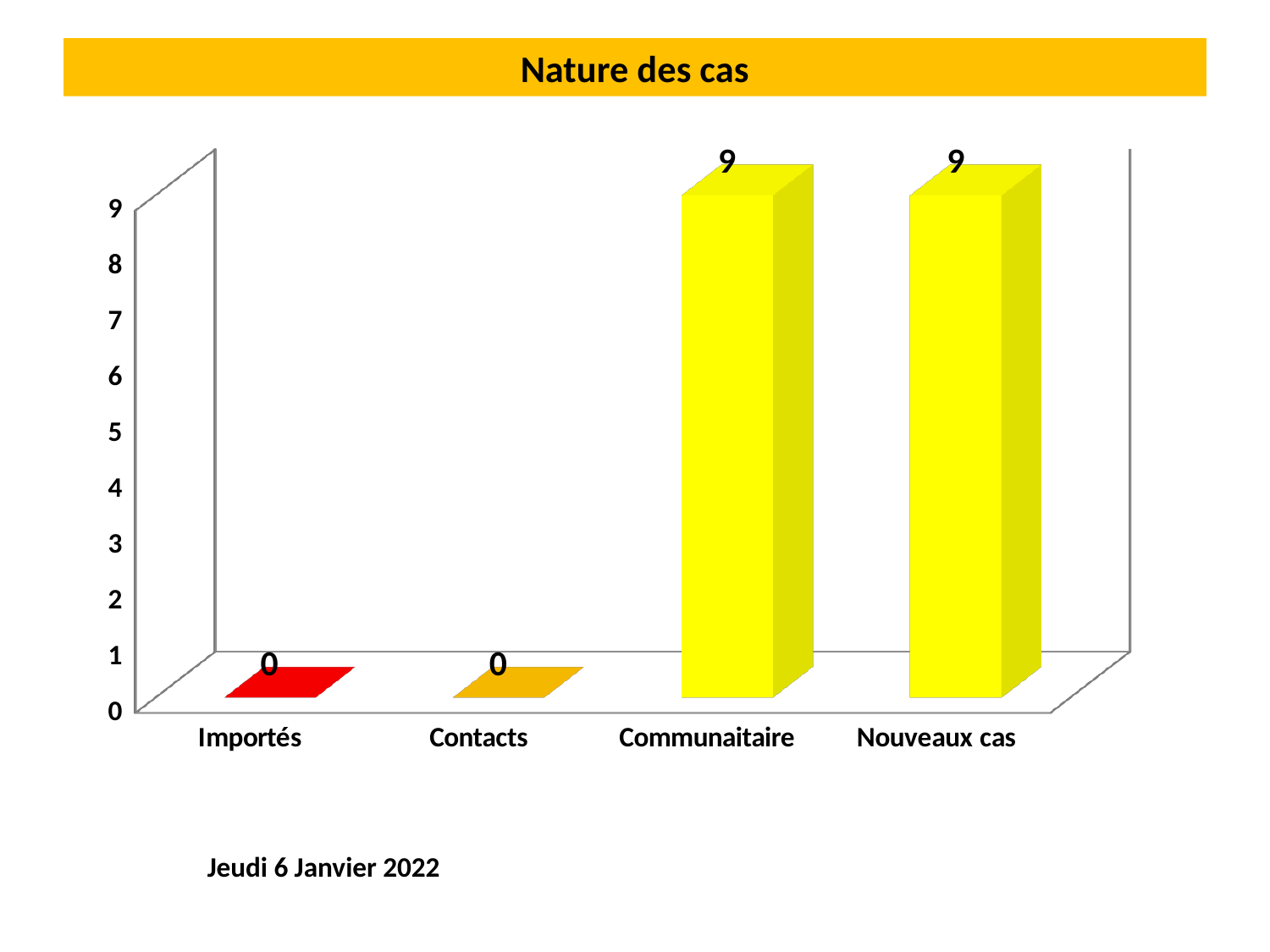
What is the title of the chart? Nature des cas What is the value for Nouveaux cas? 9 What is the value for Contacts? 0 Is the value for Nouveaux cas greater or less than 5? greater Which is larger, the value for Communaitaire or the value for Importés? Communaitaire What kind of chart is shown on the slide? bar chart What is the difference between the values for Nouveaux cas and Contacts? 9 What colour is the bar for Importés? red What is the total of the values for Importés and Contacts? 0 How many categories are shown on the x axis? 4 What is the value for Importés? 0 What is the value for Communaitaire? 9